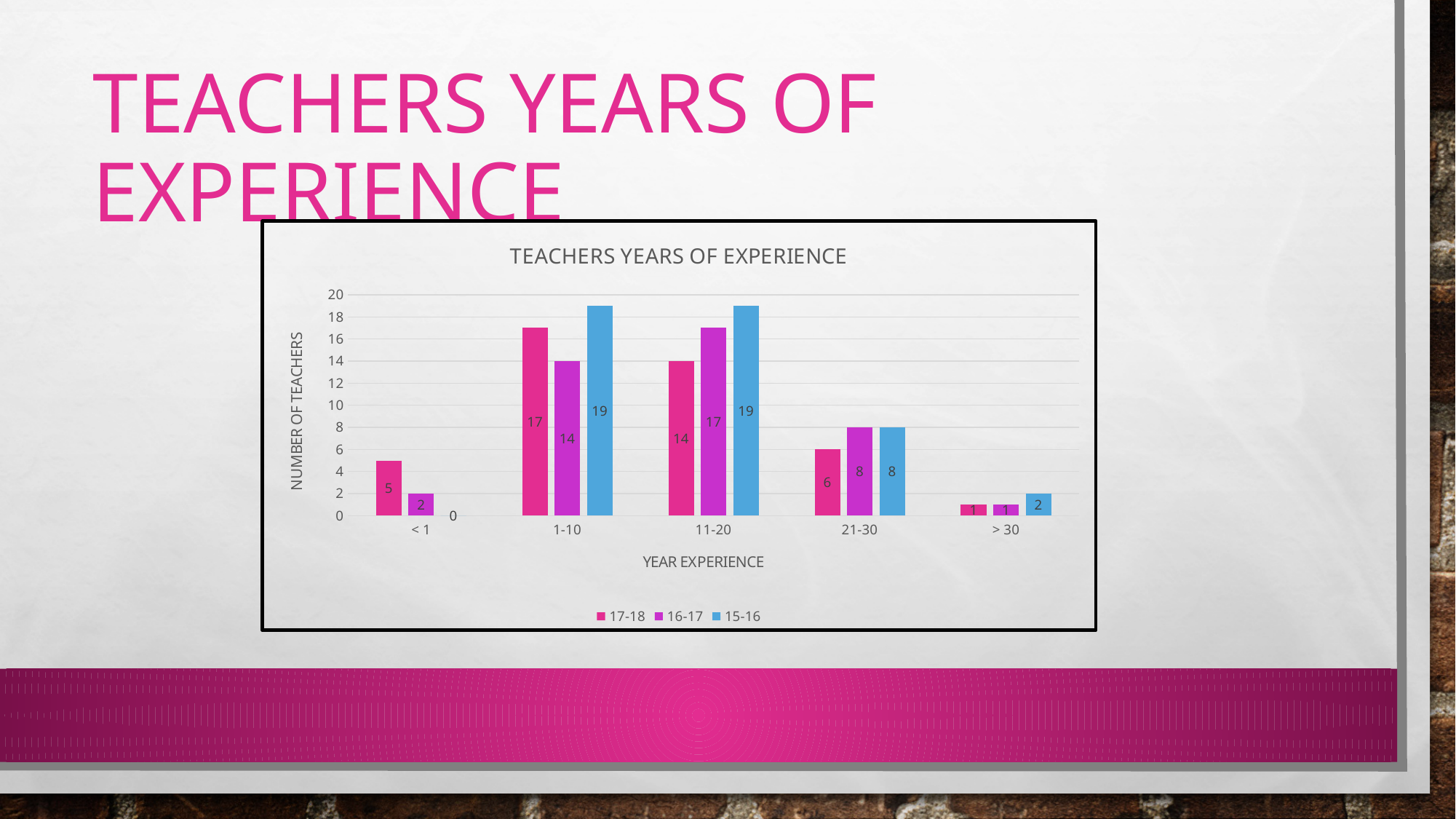
Which year-experience category has the highest value in the 17-18 series? 1-10 What is the label of the y axis? NUMBER OF TEACHERS What is the difference between the 15-16 and 16-17 values for the 1-10 category? 5 What kind of chart is shown on the slide? Bar chart Which year-experience category has the lowest value in the 15-16 series? < 1 How many series does the legend list? 3 How many year-experience categories are shown on the x axis? 5 What is the number of teachers with 21-30 years of experience in the 16-17 series? 8 What is the number of teachers with 1-10 years of experience in the 15-16 series? 19 What is the title of the chart? TEACHERS YEARS OF EXPERIENCE What is the number of teachers with less than 1 year of experience in the 17-18 series? 5 For the 11-20 category, which series has the larger value, 17-18 or 16-17? 16-17